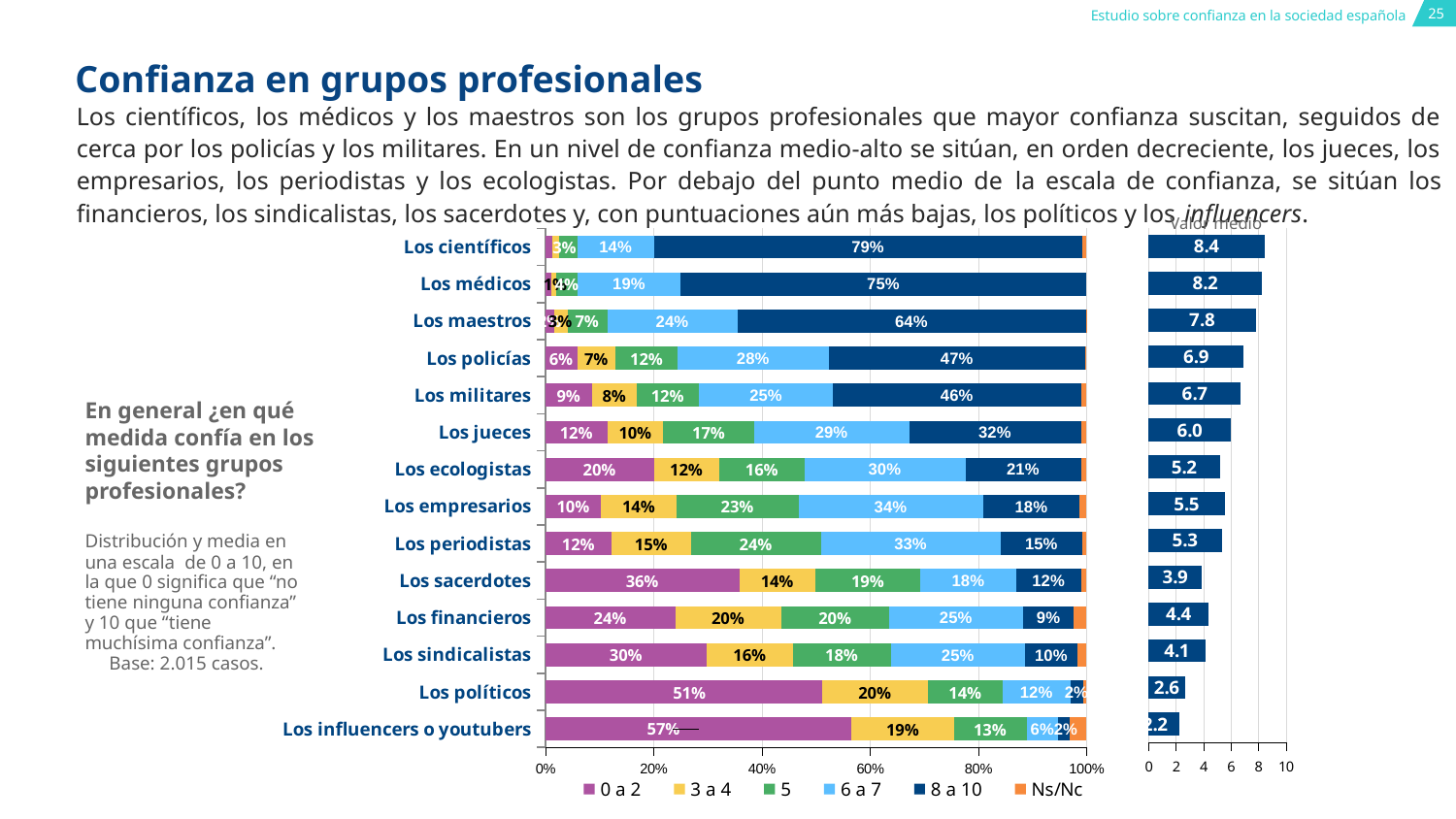
How many series does the legend of the stacked bar chart list? 6 In the 'Valor medio' chart on the right, what is the mean value for 'Los maestros'? 7.8 In the 'Valor medio' chart on the right, which professional group has the highest mean value? Los científicos How many professional groups are listed in the stacked bar chart? 14 In the stacked bar chart, what percentage of respondents gave 'Los sacerdotes' a score of 0 a 2? 36% In the stacked bar chart, what is the difference between the 8 a 10 percentage for 'Los científicos' and for 'Los médicos'? 4 percentage points In the 'Valor medio' chart on the right, is the mean value for 'Los políticos' greater or less than 4? less In the 'Valor medio' chart on the right, which professional group has the lowest mean value? Los influencers o youtubers What kind of chart is used to show the distribution of confidence across professional groups? Stacked bar chart In the 'Valor medio' chart on the right, what is the difference between the mean value for 'Los científicos' and for 'Los influencers o youtubers'? 6.2 In the stacked bar chart, which has a larger 0 a 2 percentage: 'Los políticos' or 'Los influencers o youtubers'? Los influencers o youtubers In the stacked bar chart, what percentage of respondents gave 'Los científicos' a score of 8 a 10? 79%